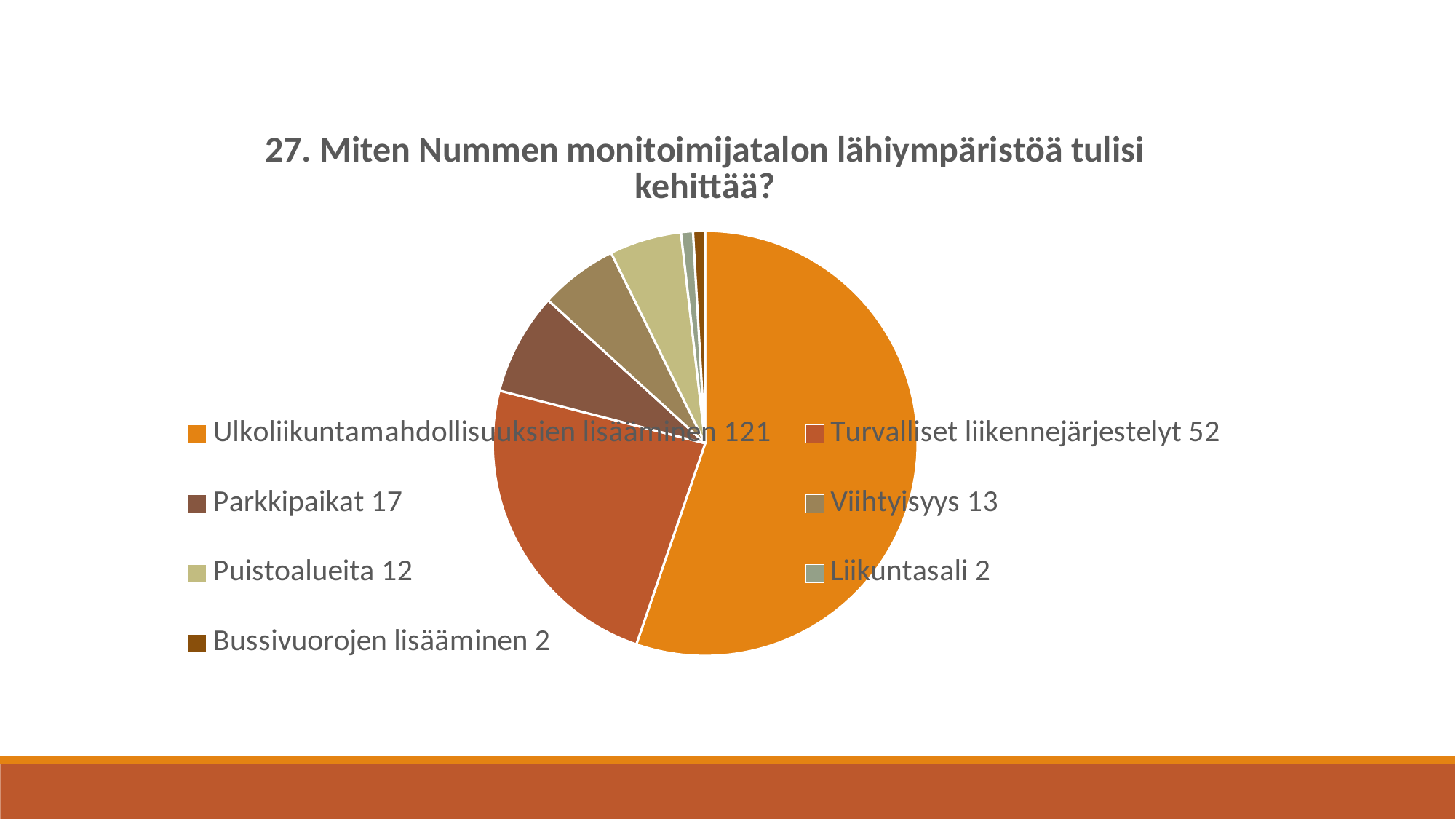
What is the value for Parkkipaikat? 17 What kind of chart is shown on the slide? pie chart Which is larger, the value for Parkkipaikat or the value for Viihtyisyys? Parkkipaikat How many categories does the pie chart have? 7 What is the value for Turvalliset liikennejärjestelyt? 52 What is the value for Ulkoliikuntamahdollisuuksien lisääminen? 121 What is the value for Viihtyisyys? 13 Which category has the highest value? Ulkoliikuntamahdollisuuksien lisääminen What is the value for Liikuntasali? 2 What is the title of the chart? 27. Miten Nummen monitoimijatalon lähiympäristöä tulisi kehittää? What is the value for Puistoalueita? 12 What is the difference between the values for Ulkoliikuntamahdollisuuksien lisääminen and Turvalliset liikennejärjestelyt? 69